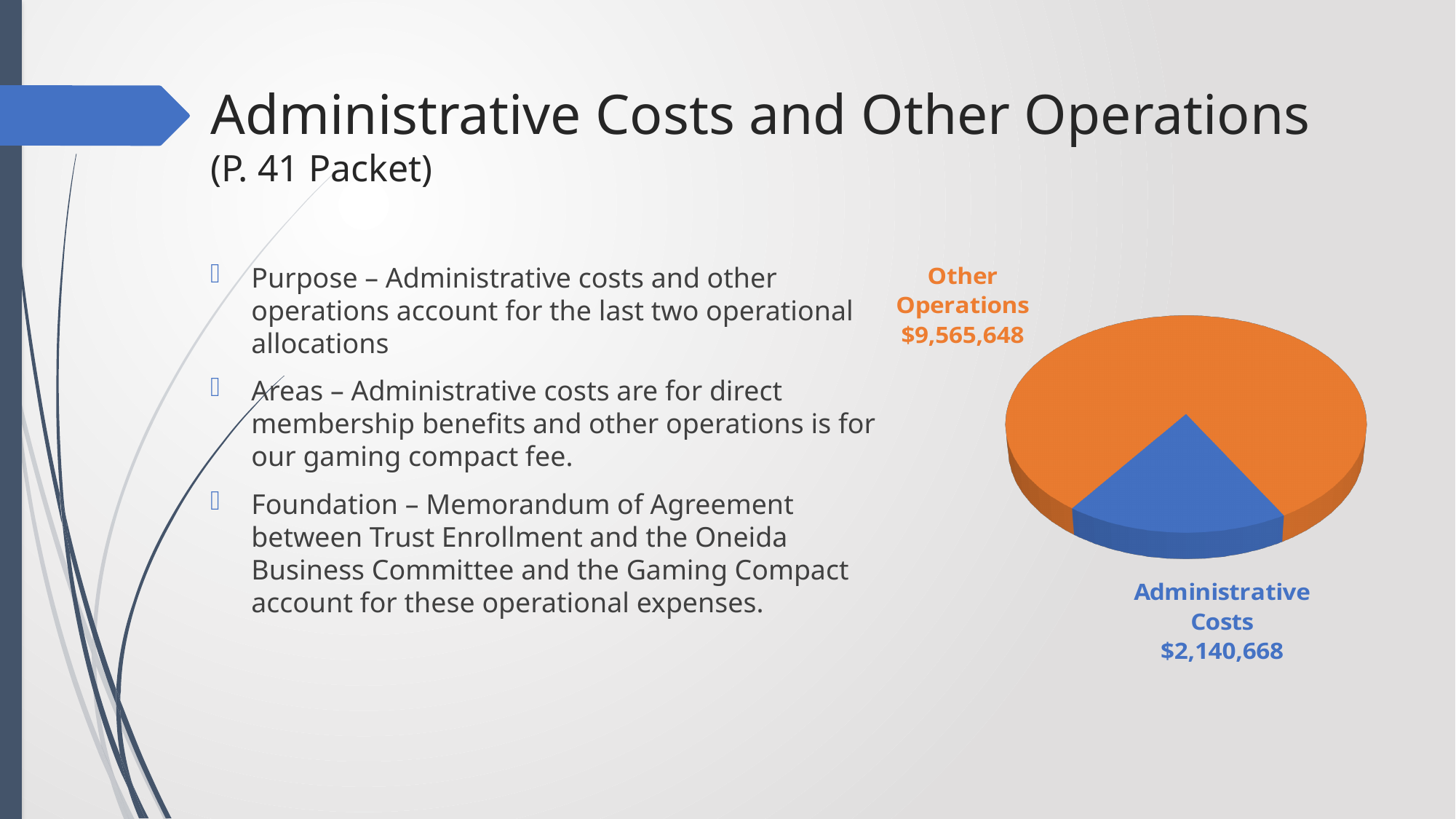
What is the difference between the Other Operations value and the Administrative Costs value in the pie chart? $7,424,980 What is the value of the Administrative Costs slice in the pie chart? $2,140,668 What is the combined total of the two slices in the pie chart? $11,706,316 Which is larger in the pie chart, Other Operations or Administrative Costs? Other Operations What is the value of the Other Operations slice in the pie chart? $9,565,648 What colour is the Administrative Costs slice in the pie chart? Blue Which slice of the pie chart is the smallest? Administrative Costs How many slices does the pie chart have? 2 What colour is the Other Operations slice in the pie chart? Orange Which slice of the pie chart is the largest? Other Operations What kind of chart is shown on the slide? Pie chart